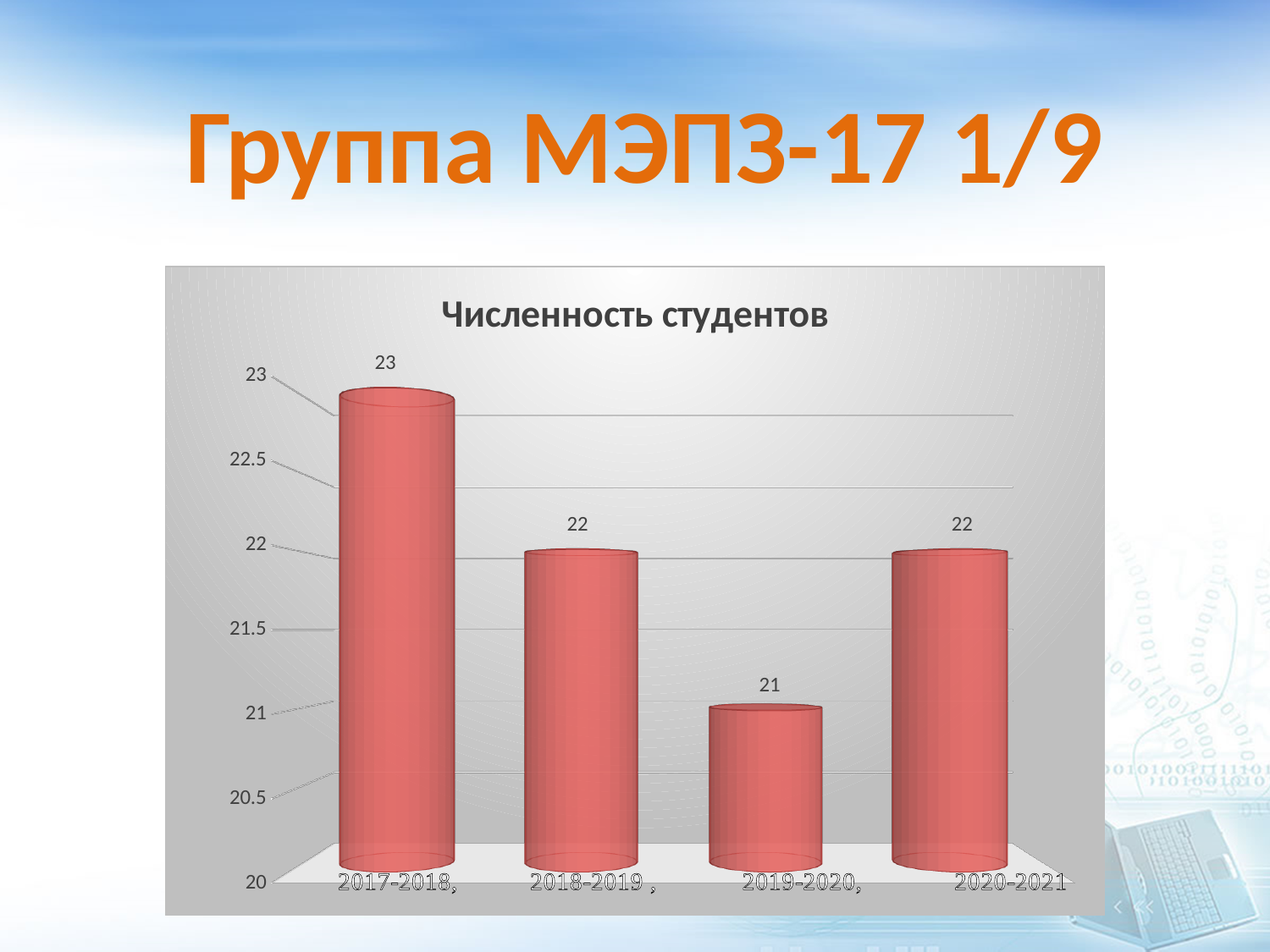
Which category has the highest value? 2017-2018 What kind of chart is shown? bar chart Which is larger, the value for 2018-2019 or the value for 2019-2020? 2018-2019 What colour are the bars in the chart? red Is the value for 2017-2018 greater or less than 22.5? greater What is the difference between the values for 2017-2018 and 2019-2020? 2 What is the value for 2019-2020? 21 How many categories are shown on the x axis? 4 What is the value for 2020-2021? 22 What is the title of the chart? Численность студентов Which category has the lowest value? 2019-2020 What is the value for 2017-2018? 23